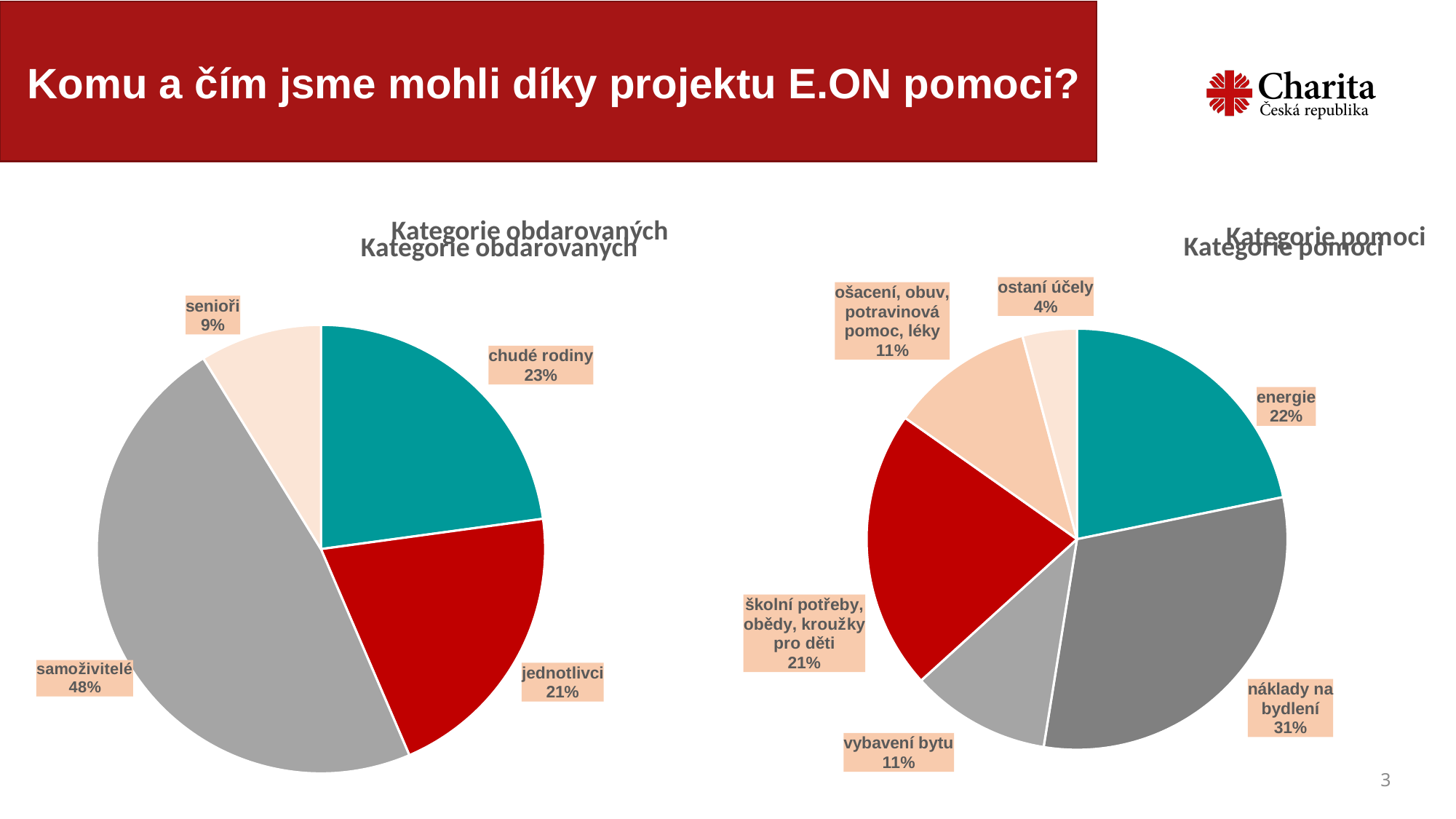
In the 'Kategorie pomoci' chart, what share is shown for náklady na bydlení? 31% In the 'Kategorie obdarovaných' chart, what share is shown for chudé rodiny? 23% In the 'Kategorie obdarovaných' chart, which category has the smallest share? senioři In the 'Kategorie obdarovaných' chart, how many categories are shown? 4 In the 'Kategorie pomoci' chart, which category has the largest share? náklady na bydlení In the 'Kategorie pomoci' chart, how many categories are shown? 6 What type of chart is the 'Kategorie pomoci' chart? Pie chart In the 'Kategorie obdarovaných' chart, what is the difference between the shares of samoživitelé and jednotlivci? 27 percentage points In the 'Kategorie obdarovaných' chart, which category has the largest share? samoživitelé In the 'Kategorie pomoci' chart, which is larger: energie or vybavení bytu? energie In the 'Kategorie pomoci' chart, what share is shown for ostaní účely? 4% In the 'Kategorie obdarovaných' chart, what share is shown for samoživitelé? 48%